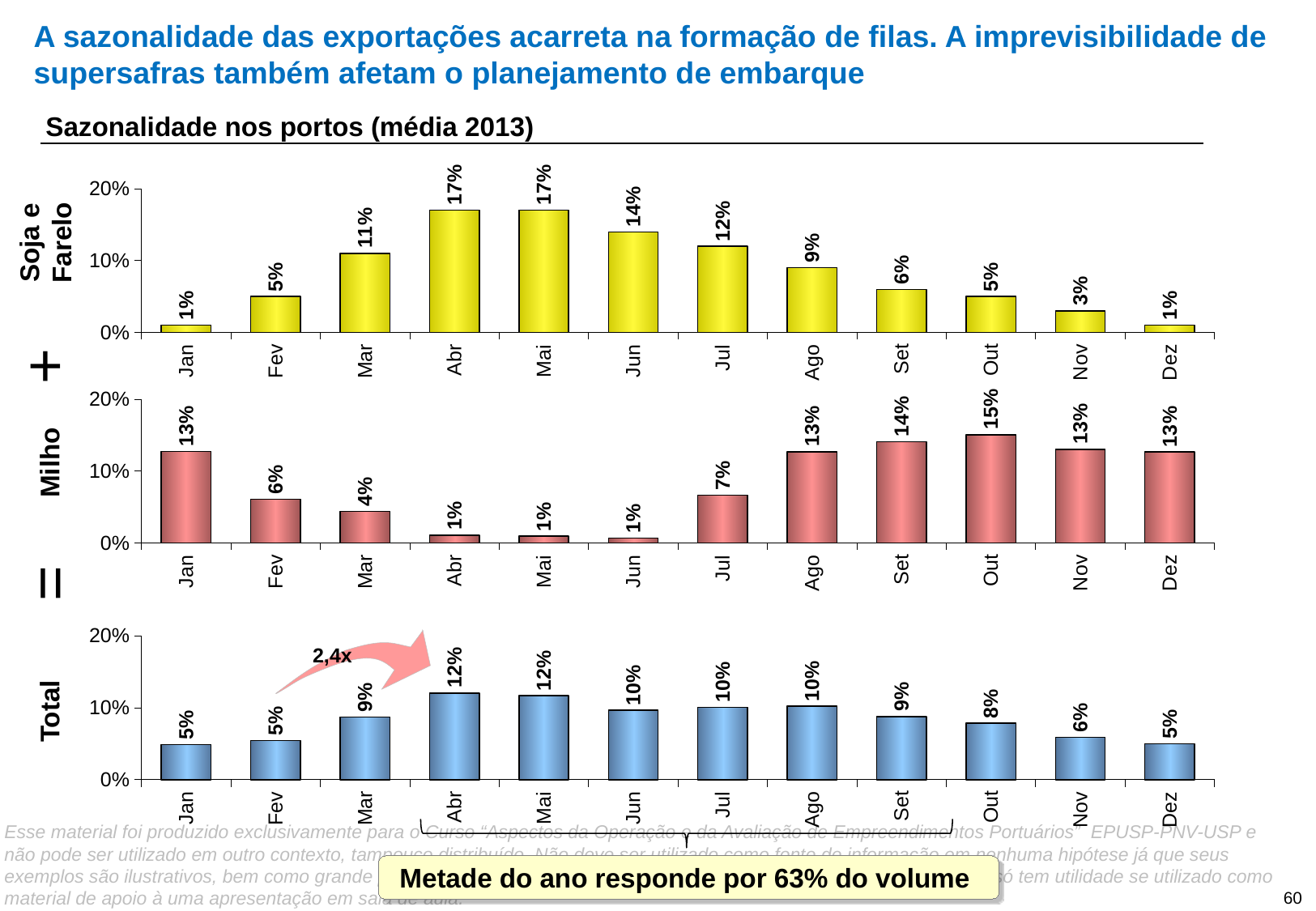
In the Soja e Farelo chart, which is larger, the value for Jun or the value for Ago? Jun How many months are shown on the x axis of the Total chart? 12 In the Total chart, what is the value for Jun? 10% In the Soja e Farelo chart, what is the difference between the values for Abr and Jan? 16 percentage points What multiplier is written next to the arrow in the Total chart? 2,4x In the Milho chart, which month has the highest value? Out In the Total chart, is the value for Abr greater or less than 10%? greater In the Soja e Farelo chart, do the values rise or fall from Mai to Dez? Fall In the Milho chart, what is the difference between the values for Out and Mar? 11 percentage points What kind of chart is the Milho chart? Bar chart In the Soja e Farelo chart, what is the value for Abr? 17% In the Milho chart, what is the value for Jan? 13%